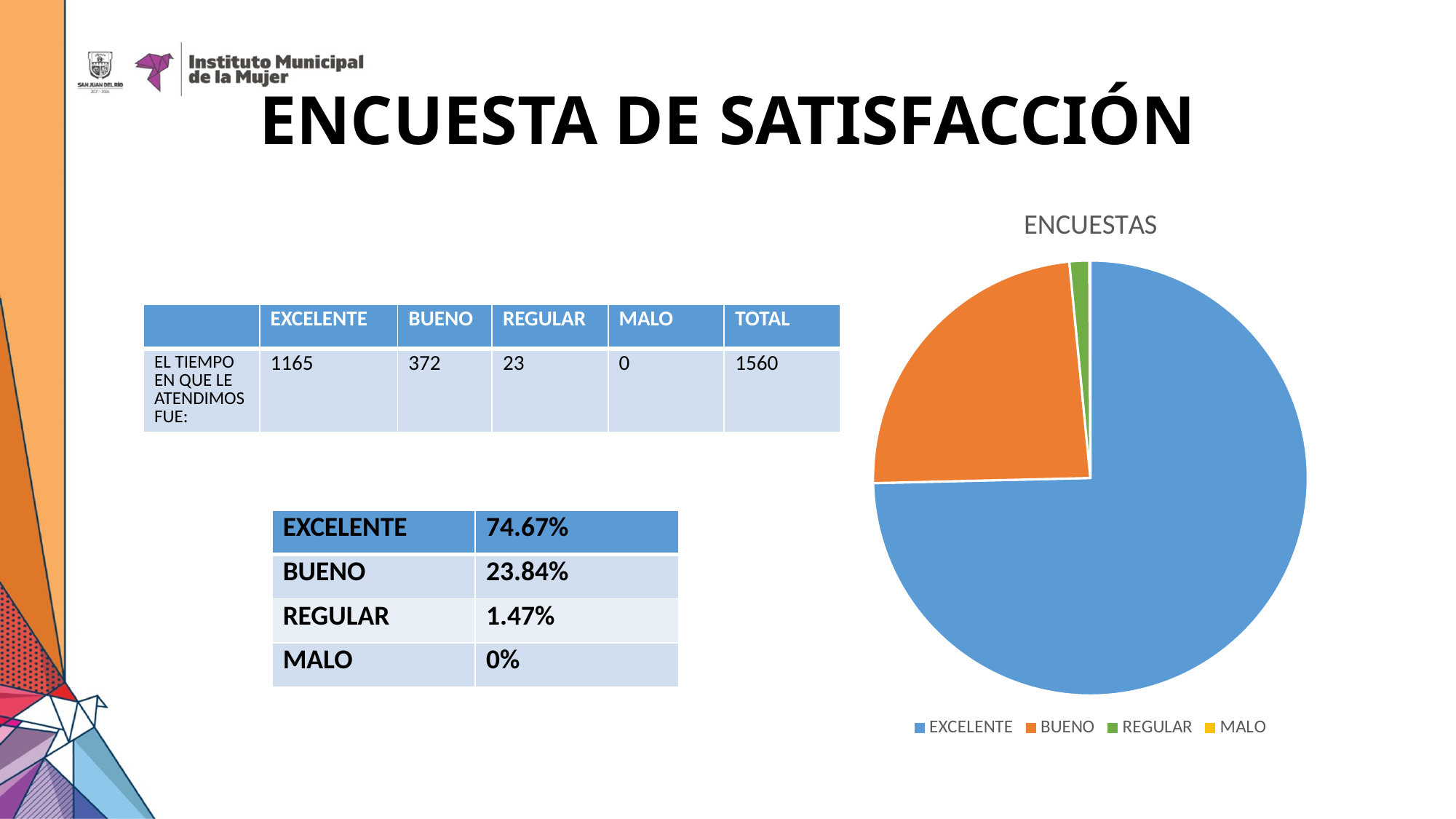
Which slice is larger in the pie chart, BUENO or REGULAR? BUENO According to the table on the slide, how many responses were REGULAR? 23 Which category has the smallest share of the pie chart? MALO What kind of chart is shown on the slide? pie chart Is the share of the pie for EXCELENTE greater or less than 50%? greater What share of the pie does EXCELENTE represent, according to the percentage table on the slide? 74.67% Which category has the largest slice of the pie chart? EXCELENTE According to the table on the slide, what is the difference between the EXCELENTE and BUENO response counts? 793 What is the title of the pie chart? ENCUESTAS How many categories does the pie chart's legend list? 4 According to the table on the slide, what is the total number of responses plotted in the pie chart? 1560 What share of the pie does BUENO represent, according to the percentage table on the slide? 23.84%